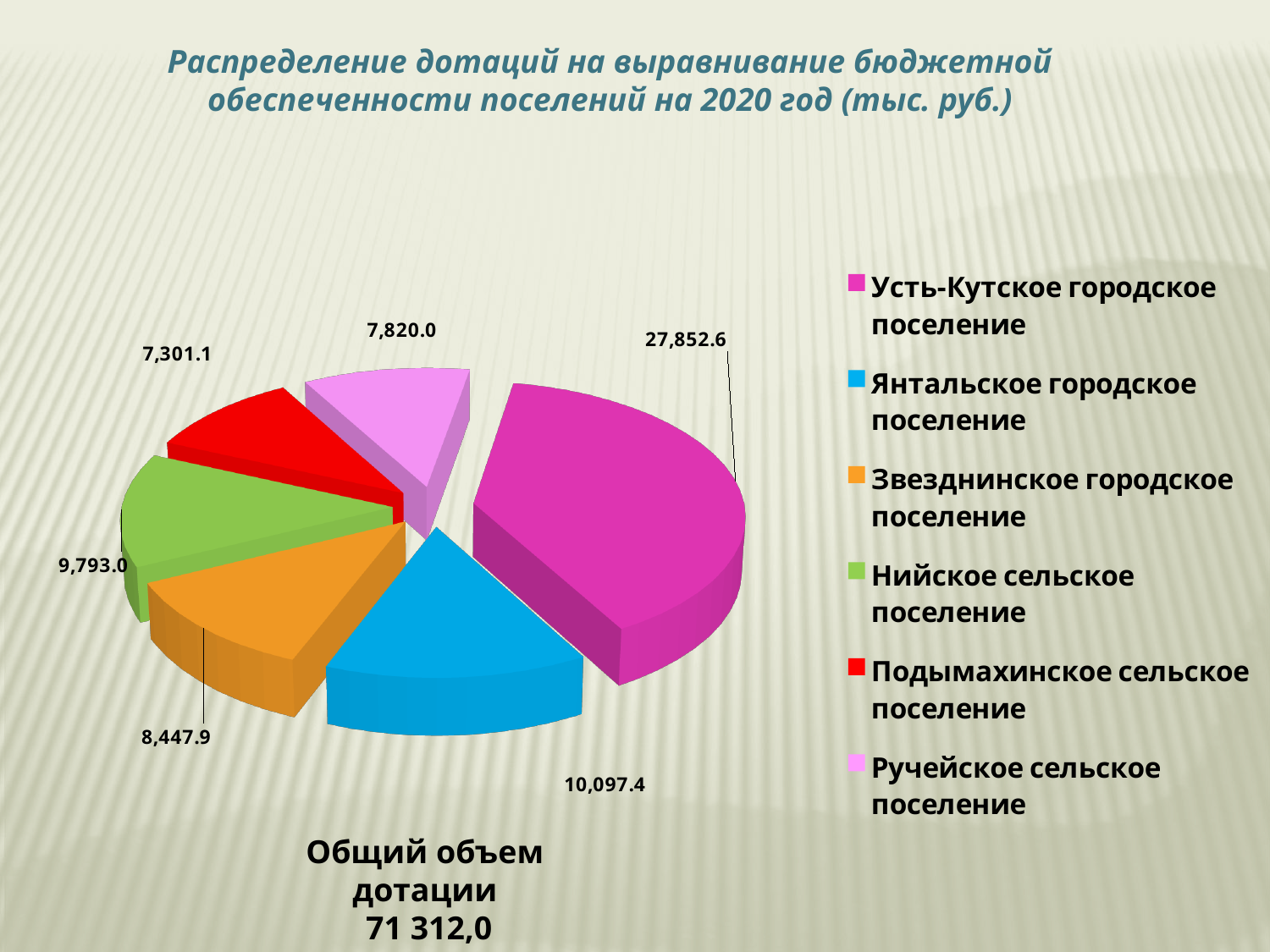
How many slices does the pie chart have? 6 What is the difference between the values for Усть-Кутское городское поселение and Янтальское городское поселение? 17,755.2 Which is larger: the value for Звезднинское городское поселение or Нийское сельское поселение? Нийское сельское поселение What is the value for Янтальское городское поселение? 10,097.4 What is the value for Ручейское сельское поселение? 7,820.0 What is the value for Нийское сельское поселение? 9,793.0 What is the total volume of the subsidy shown on the slide? 71 312,0 What is the value for Усть-Кутское городское поселение? 27,852.6 Which settlement receives the largest share of the subsidy? Усть-Кутское городское поселение Which colour represents Подымахинское сельское поселение in the legend? Red What type of chart is shown on the slide? Pie chart Which settlement receives the smallest share of the subsidy? Подымахинское сельское поселение